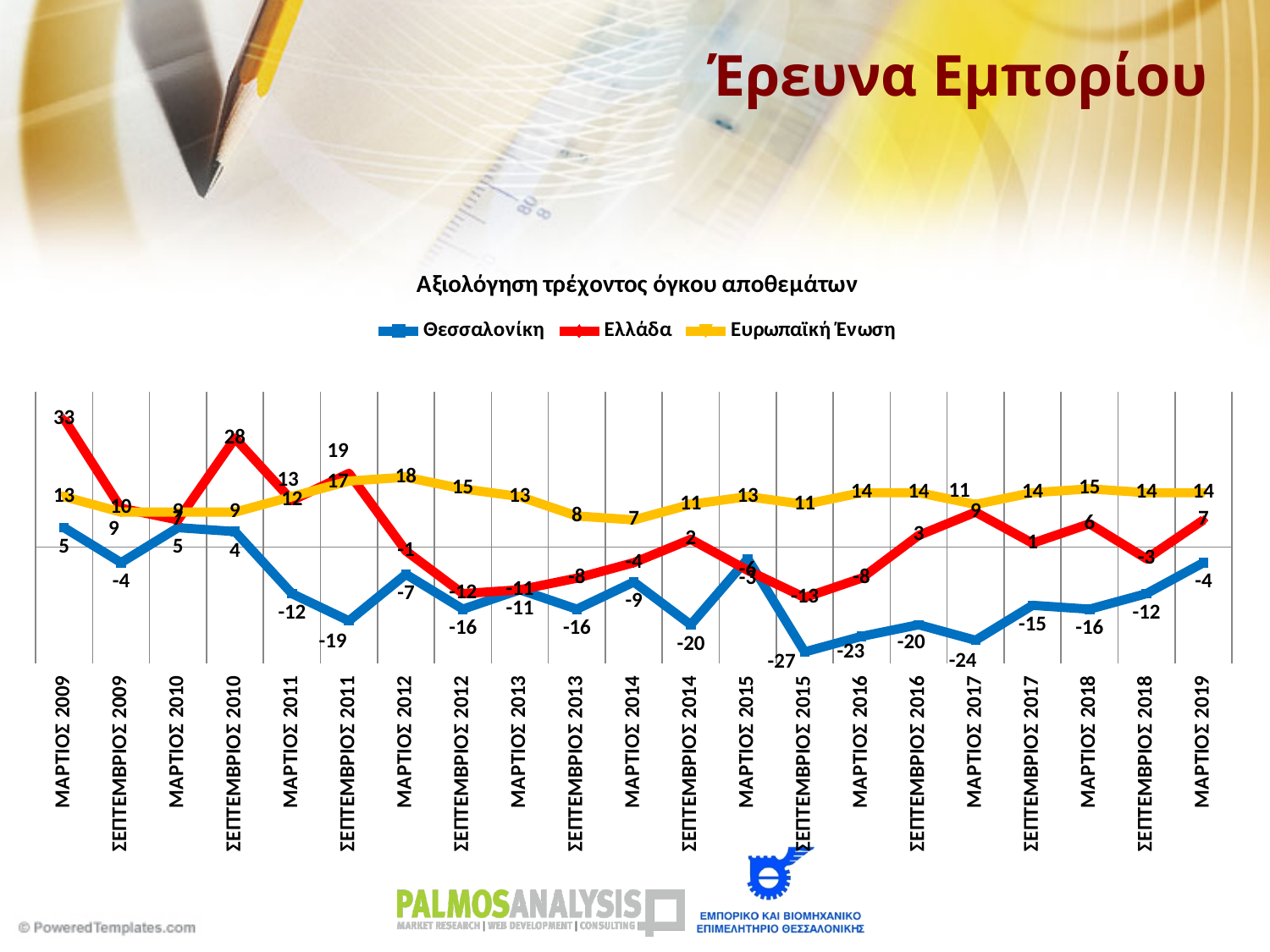
What is the difference between the Ελλάδα values in ΜΑΡΤΙΟΣ 2009 and ΣΕΠΤΕΜΒΡΙΟΣ 2010? 5 What is the value for Ελλάδα in ΜΑΡΤΙΟΣ 2009? 33 What is the title of the chart? Αξιολόγηση τρέχοντος όγκου αποθεμάτων How many time points are plotted along the x axis? 21 How many series does the legend list? 3 In which period does Ελλάδα reach its highest value? ΜΑΡΤΙΟΣ 2009 What kind of chart is shown on the slide? line chart What is the value for Ευρωπαϊκή Ένωση in ΣΕΠΤΕΜΒΡΙΟΣ 2011? 17 What is the value for Θεσσαλονίκη in ΣΕΠΤΕΜΒΡΙΟΣ 2015? -27 In ΜΑΡΤΙΟΣ 2019, which series has the higher value, Ελλάδα or Θεσσαλονίκη? Ελλάδα What is the value for Θεσσαλονίκη in ΜΑΡΤΙΟΣ 2019? -4 In which period does Θεσσαλονίκη reach its lowest value? ΣΕΠΤΕΜΒΡΙΟΣ 2015